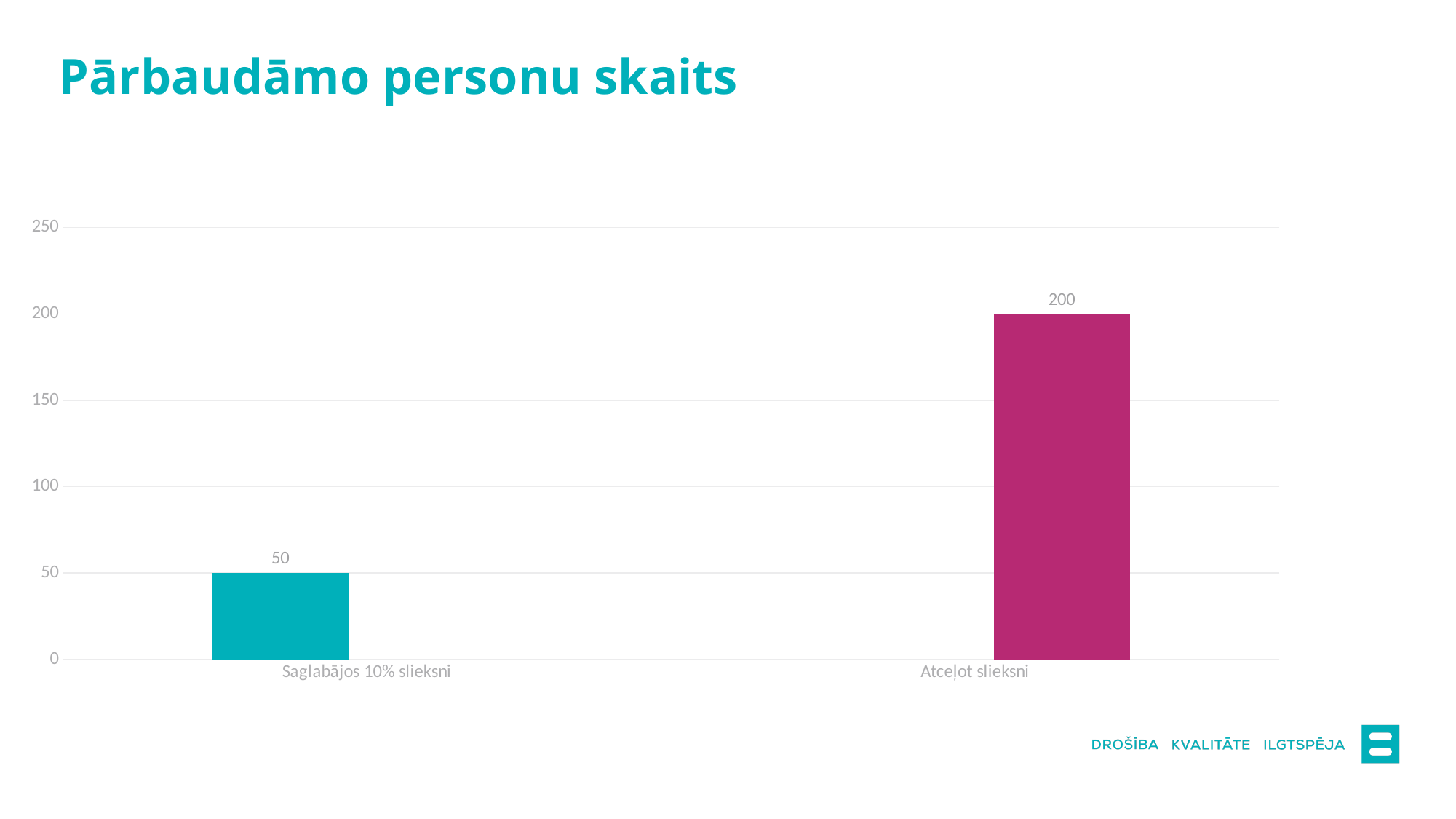
Which category has the lowest value? Saglabājos 10% slieksni What is the value for "Atceļot slieksni"? 200 What is the difference between the values for "Atceļot slieksni" and "Saglabājos 10% slieksni"? 150 Is the value for "Saglabājos 10% slieksni" greater or less than 100? less What is the title of the slide? Pārbaudāmo personu skaits Is the value for "Atceļot slieksni" greater or less than 150? greater What colour is the bar for "Atceļot slieksni"? Magenta What kind of chart is shown on the slide? Bar chart Which is larger: the value for "Saglabājos 10% slieksni" or the value for "Atceļot slieksni"? Atceļot slieksni What is the value for "Saglabājos 10% slieksni"? 50 Which category has the highest value? Atceļot slieksni How many categories are shown in the chart? 2